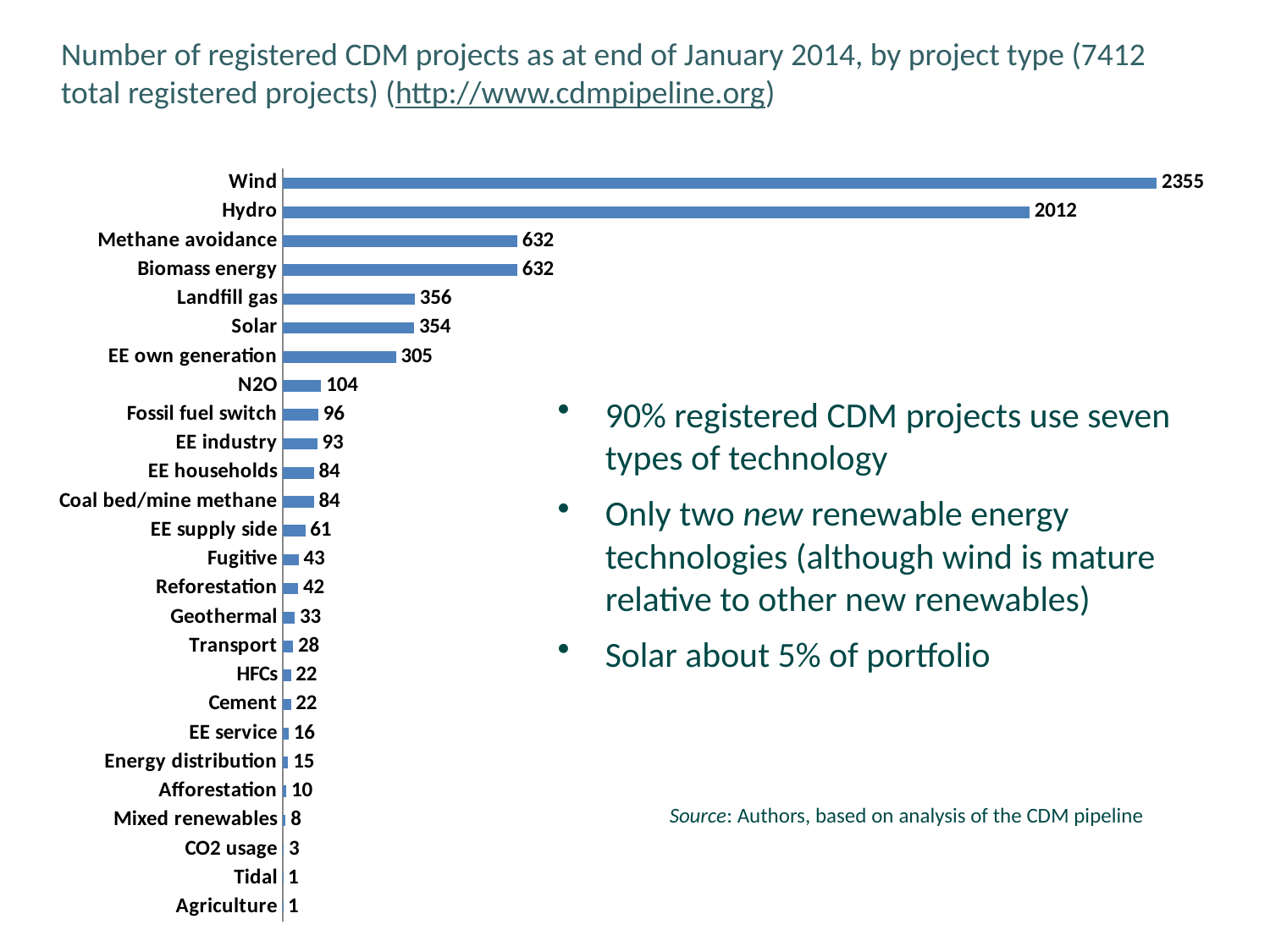
What is the value for EE own generation? 305 How many registered projects are shown for Solar? 354 How many project types are shown in the chart? 26 What is the difference between the values for Methane avoidance and Landfill gas? 276 What is the number of registered CDM projects for Wind? 2355 Which has a larger value, N2O or Fugitive? N2O What kind of chart is shown on the slide? Bar chart Which has a larger value, Hydro or Biomass energy? Hydro What is the value shown for Geothermal? 33 Which project type has the highest number of registered CDM projects? Wind What is the value shown for Hydro? 2012 What is the difference between the values for Wind and Hydro? 343